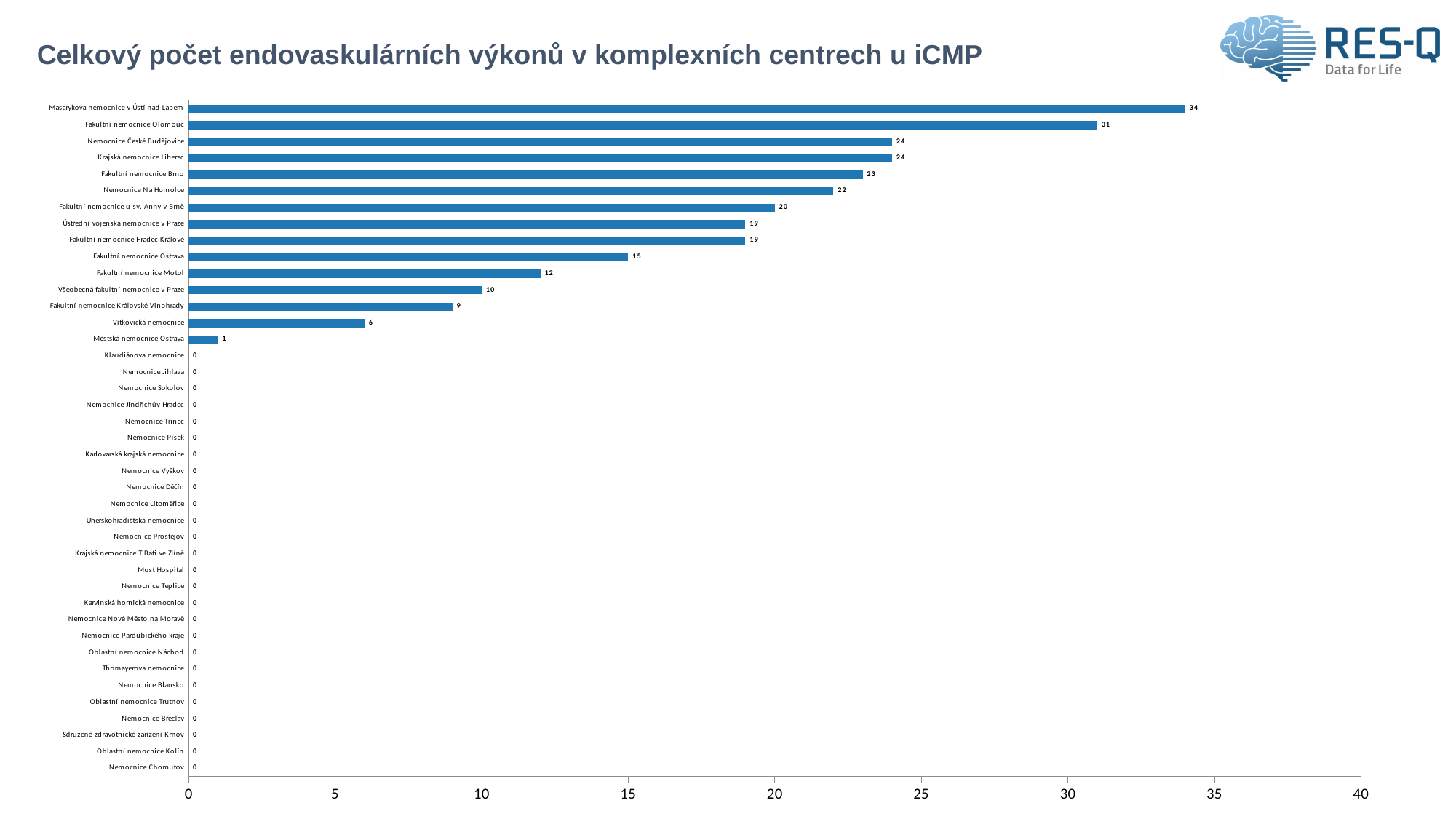
Is the value for Fakultní nemocnice Hradec Králové greater or less than 15? greater Which hospital has the highest value? Masarykova nemocnice v Ústí nad Labem What kind of chart is shown on the slide? bar chart What is the value for Masarykova nemocnice v Ústí nad Labem? 34 Which is larger, the value for Nemocnice Na Homolce or the value for Fakultní nemocnice u sv. Anny v Brně? Nemocnice Na Homolce What is the value for Fakultní nemocnice Olomouc? 31 What is the difference between Fakultní nemocnice Brno and Fakultní nemocnice Ostrava? 8 What is the value for Fakultní nemocnice Motol? 12 How many hospitals are listed on the chart? 41 What is the value for Vítkovická nemocnice? 6 What is the title of the chart? Celkový počet endovaskulárních výkonů v komplexních centrech u iCMP What is the difference between Masarykova nemocnice v Ústí nad Labem and Fakultní nemocnice Olomouc? 3